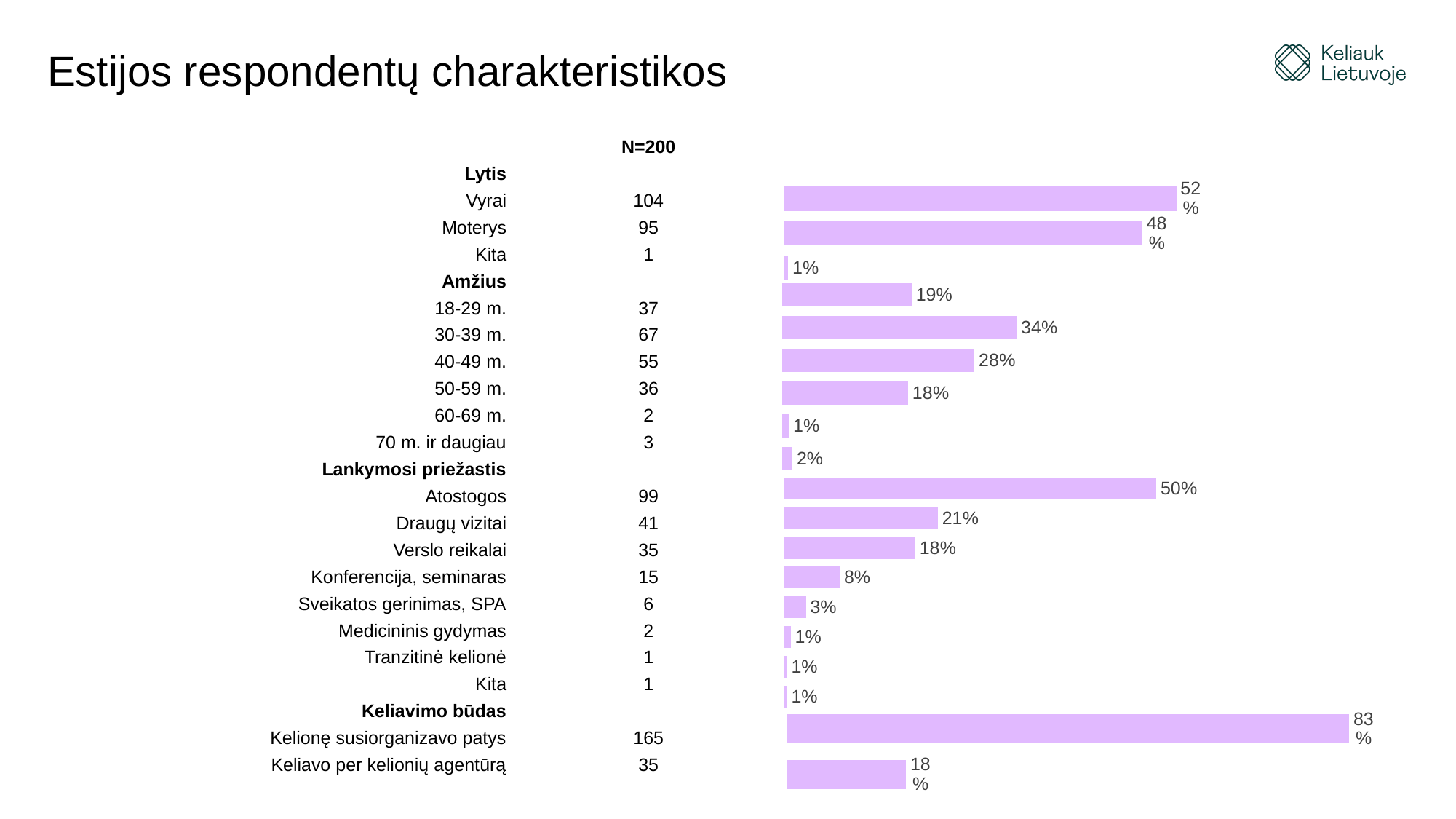
Which has a larger percentage, Verslo reikalai or Konferencija, seminaras? Verslo reikalai Which visit reason (Lankymosi priežastis) has the highest percentage? Atostogos What is the difference in percentage points between Vyrai and Moterys? 4 What percentage does the bar for Vyrai show? 52% Which has a larger percentage, 40-49 m. or 50-59 m.? 40-49 m. What is the difference in percentage points between Atostogos and Draugų vizitai? 29 What percentage does the bar for 30-39 m. show? 34% What percentage does the bar for Kelionę susiorganizavo patys show? 83% What is the sample size (N) stated above the table? N=200 What type of chart is shown on the slide? Bar chart What percentage does the bar for Atostogos show? 50% Which age group (Amžius) has the highest percentage? 30-39 m.